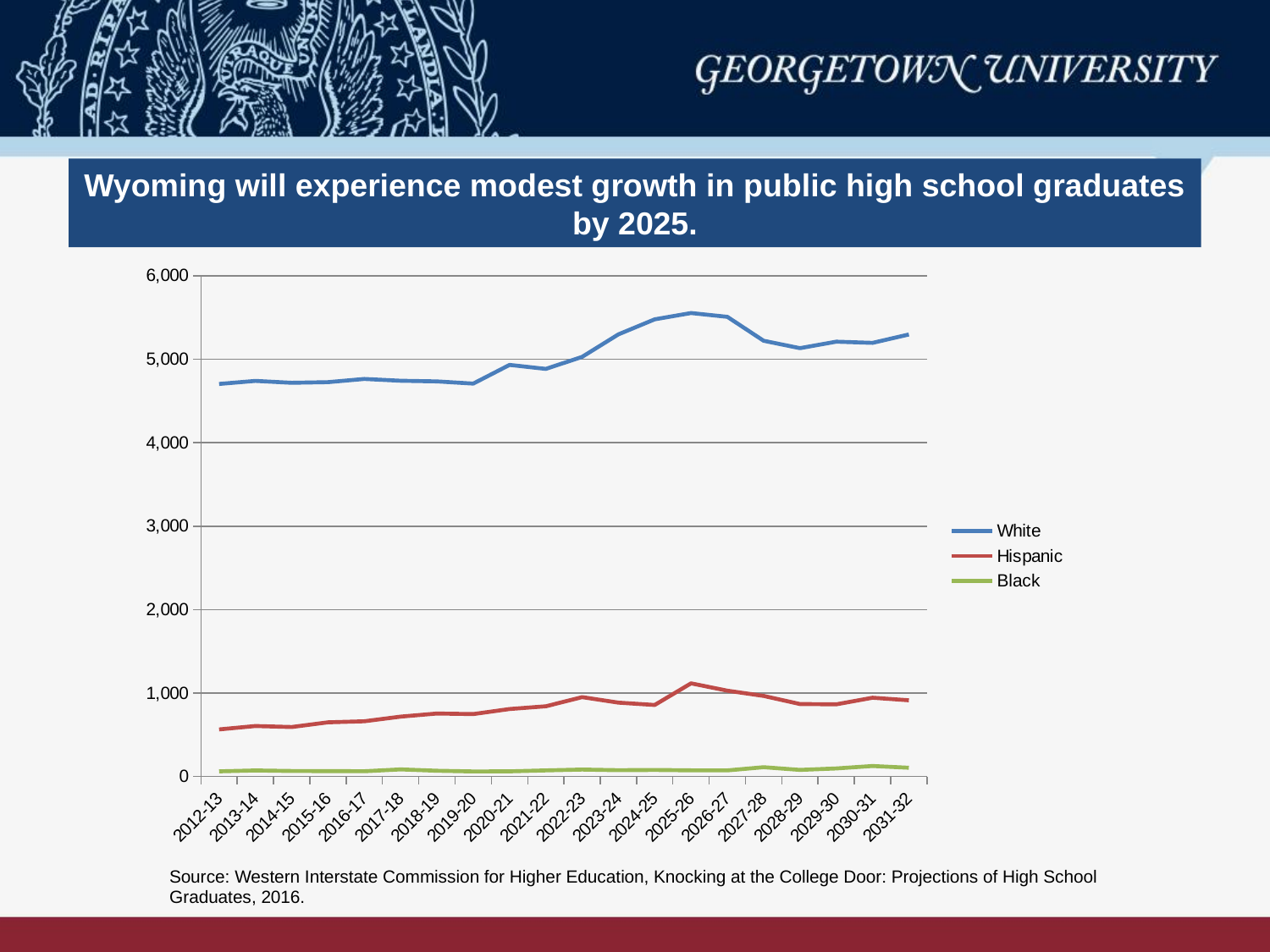
What colour is the line for the Hispanic series? Red Which series has the highest values throughout the chart? White How many school years are plotted along the x axis? 20 How many series does the legend list? 3 Is the value for Hispanic in 2012-13 greater or less than 1,000? less Is the value for Hispanic in 2025-26 greater or less than 1,000? greater Is the value for White in 2025-26 greater or less than 5,000? greater What kind of chart is shown on the slide? Line chart Does the White series rise or fall from 2019-20 to 2025-26? rise Which series has the lowest values throughout the chart? Black Which is larger in 2031-32, the value for White or the value for Hispanic? White